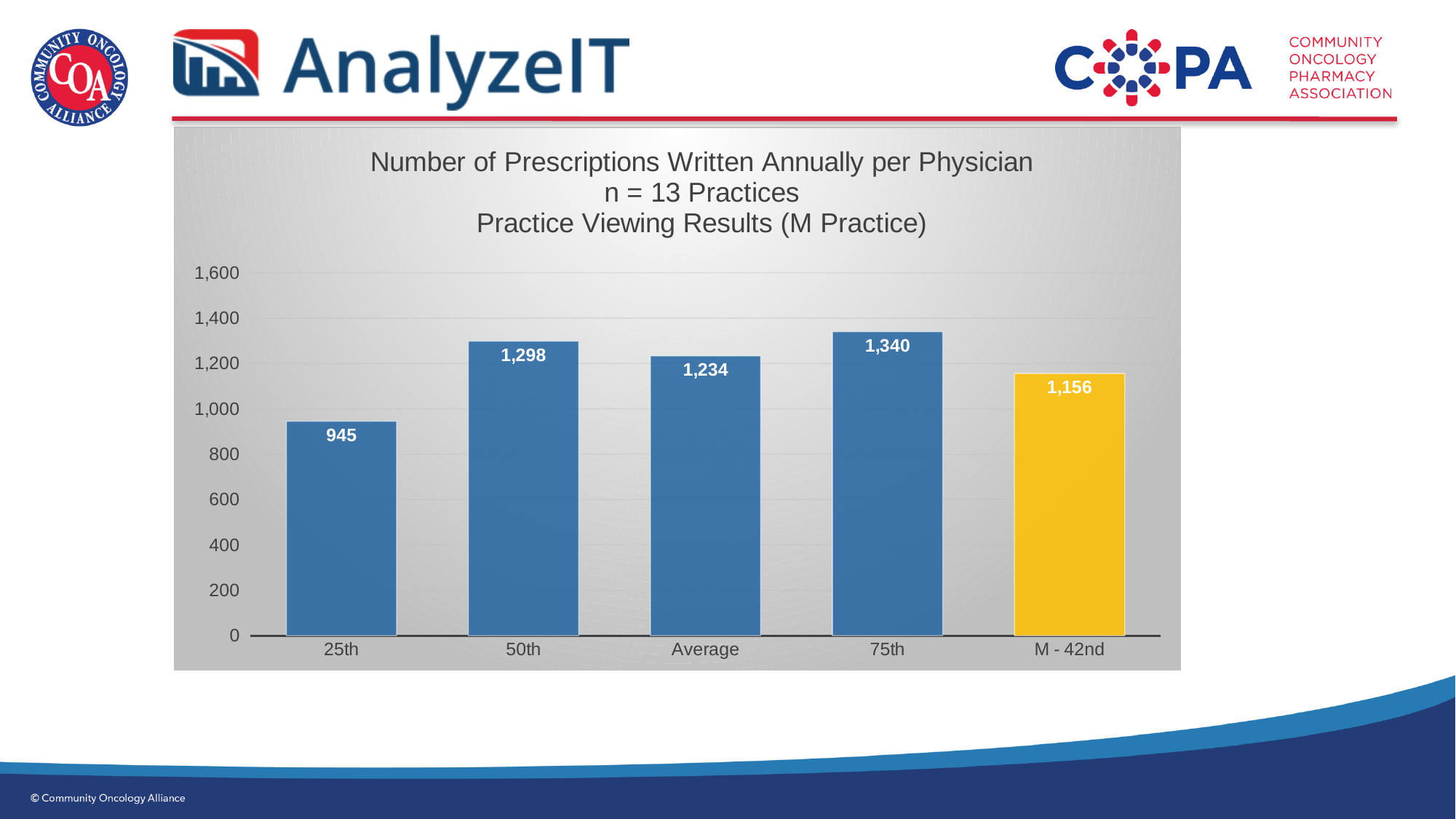
Is the value for M - 42nd greater or less than 1,200? less How many categories are shown on the x axis? 5 What is the value for the 25th category? 945 What is the value for the M - 42nd category? 1,156 Which category has the lowest value? 25th What is the difference between the 75th value and the 25th value? 395 What is the difference between the 50th value and the M - 42nd value? 142 What is the value for the Average category? 1,234 Which is larger, the value for 50th or the value for Average? 50th Which category has the highest value? 75th What kind of chart is shown on the slide? bar chart Which bar is coloured differently (yellow) from the others? M - 42nd